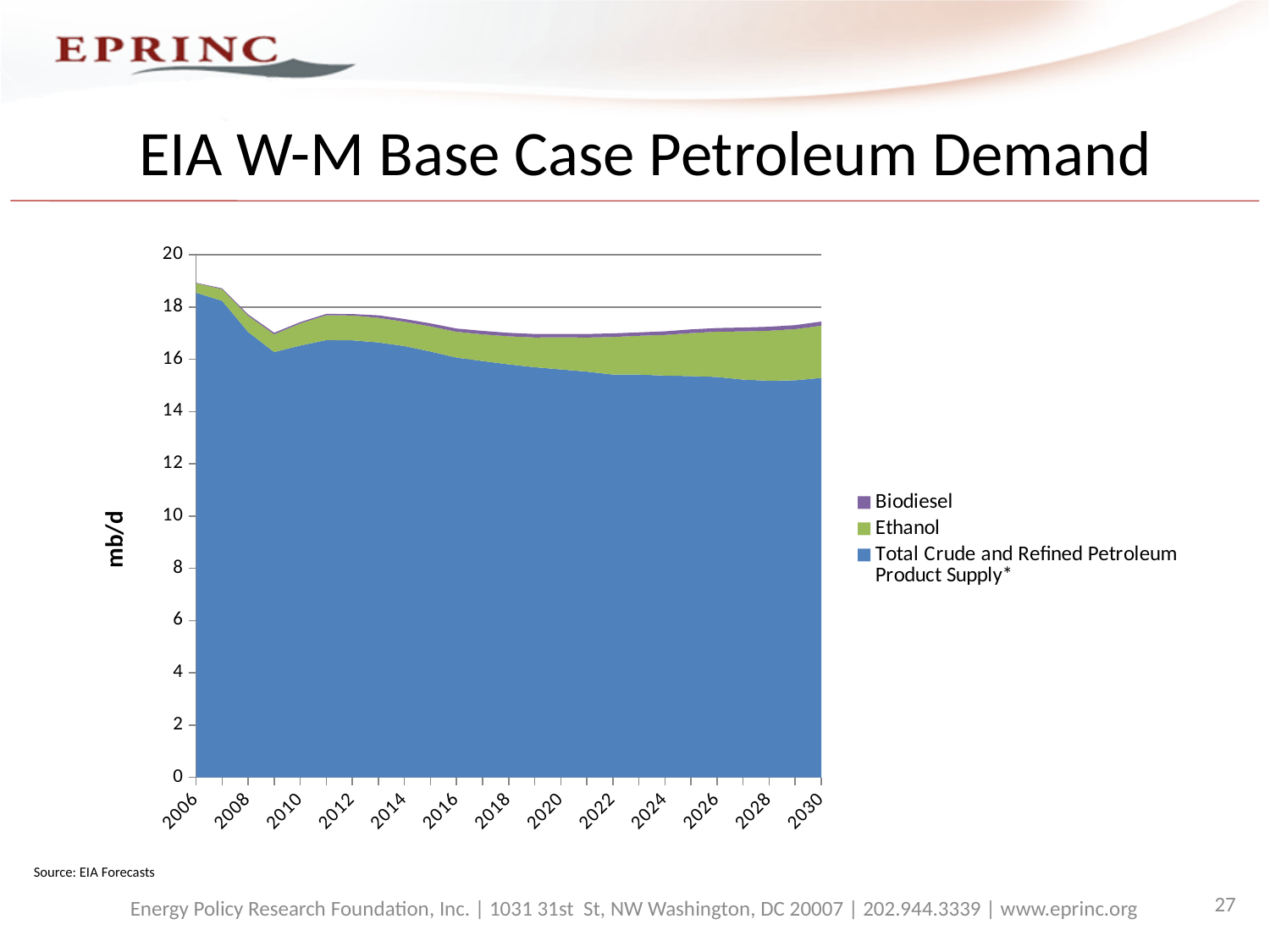
Is the total stacked value in 2030 greater or less than 18? less Does the Total Crude and Refined Petroleum Product Supply* series rise or fall from 2006 to 2030? fall How many series does the legend list? 3 What kind of chart is shown on the slide? Stacked area chart Is the total stacked value in 2006 greater or less than 18? greater Is the value for Total Crude and Refined Petroleum Product Supply* larger in 2006 or in 2030? 2006 What is the label on the vertical axis? mb/d Is the value for Total Crude and Refined Petroleum Product Supply* in 2030 greater or less than 16? less What is the title of the chart? EIA W-M Base Case Petroleum Demand Which series occupies the largest area of the chart? Total Crude and Refined Petroleum Product Supply* How many year labels are shown along the x axis? 13 Which series occupies the smallest area of the chart? Biodiesel